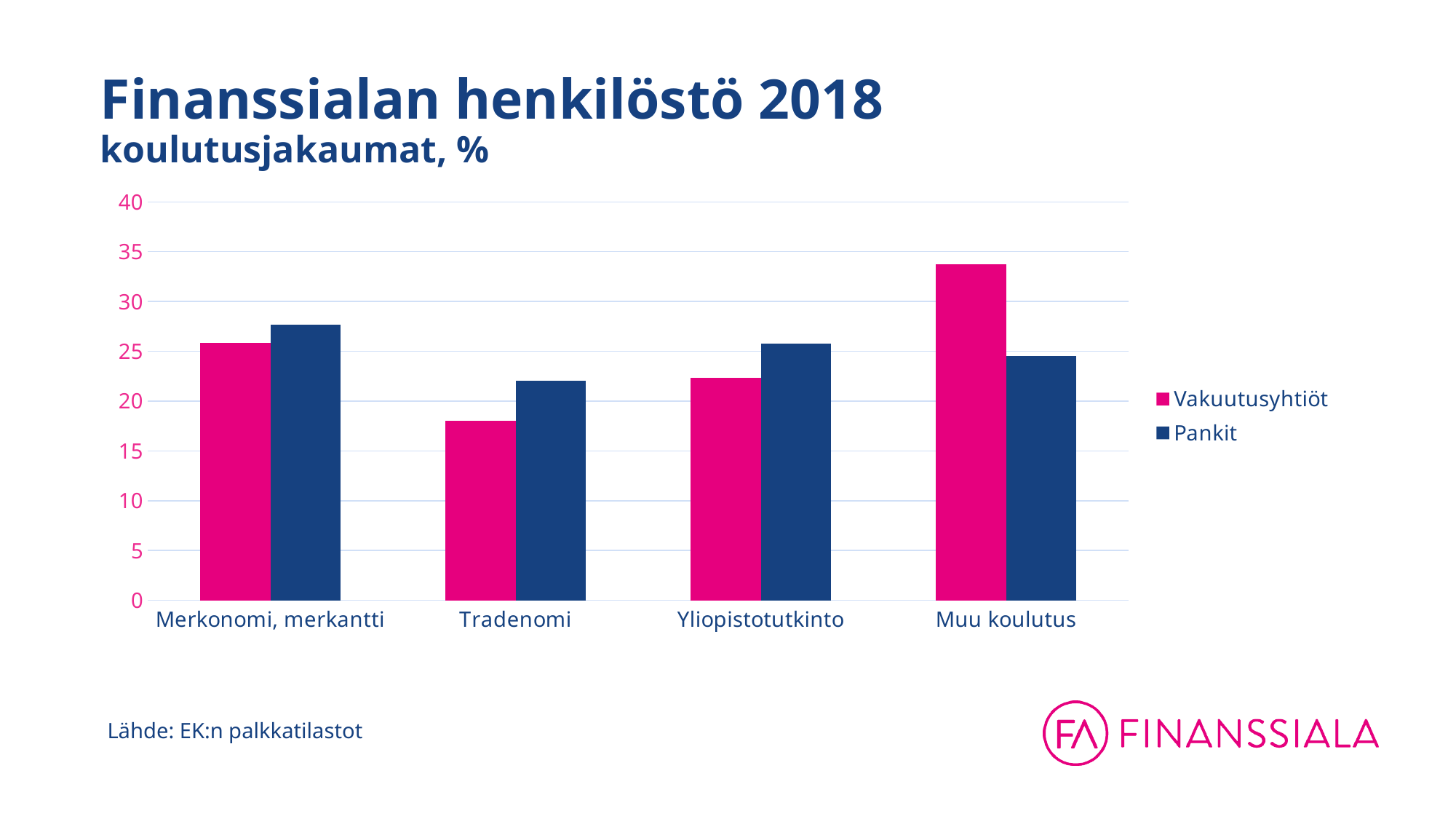
Is the Vakuutusyhtiöt value for Tradenomi greater or less than 20? less Is the Vakuutusyhtiöt value for Muu koulutus greater or less than 30? greater How many education categories are shown on the x axis? 4 For Tradenomi, which series has the larger value, Vakuutusyhtiöt or Pankit? Pankit What colour are the Pankit bars? dark blue Is the Pankit value for Merkonomi, merkantti greater or less than 30? less Which category has the lowest value for Vakuutusyhtiöt? Tradenomi For Muu koulutus, which series has the larger value, Vakuutusyhtiöt or Pankit? Vakuutusyhtiöt What kind of chart is shown on the slide? bar chart Which category has the lowest value for Pankit? Tradenomi How many series does the legend list? 2 Which category has the highest value for Vakuutusyhtiöt? Muu koulutus